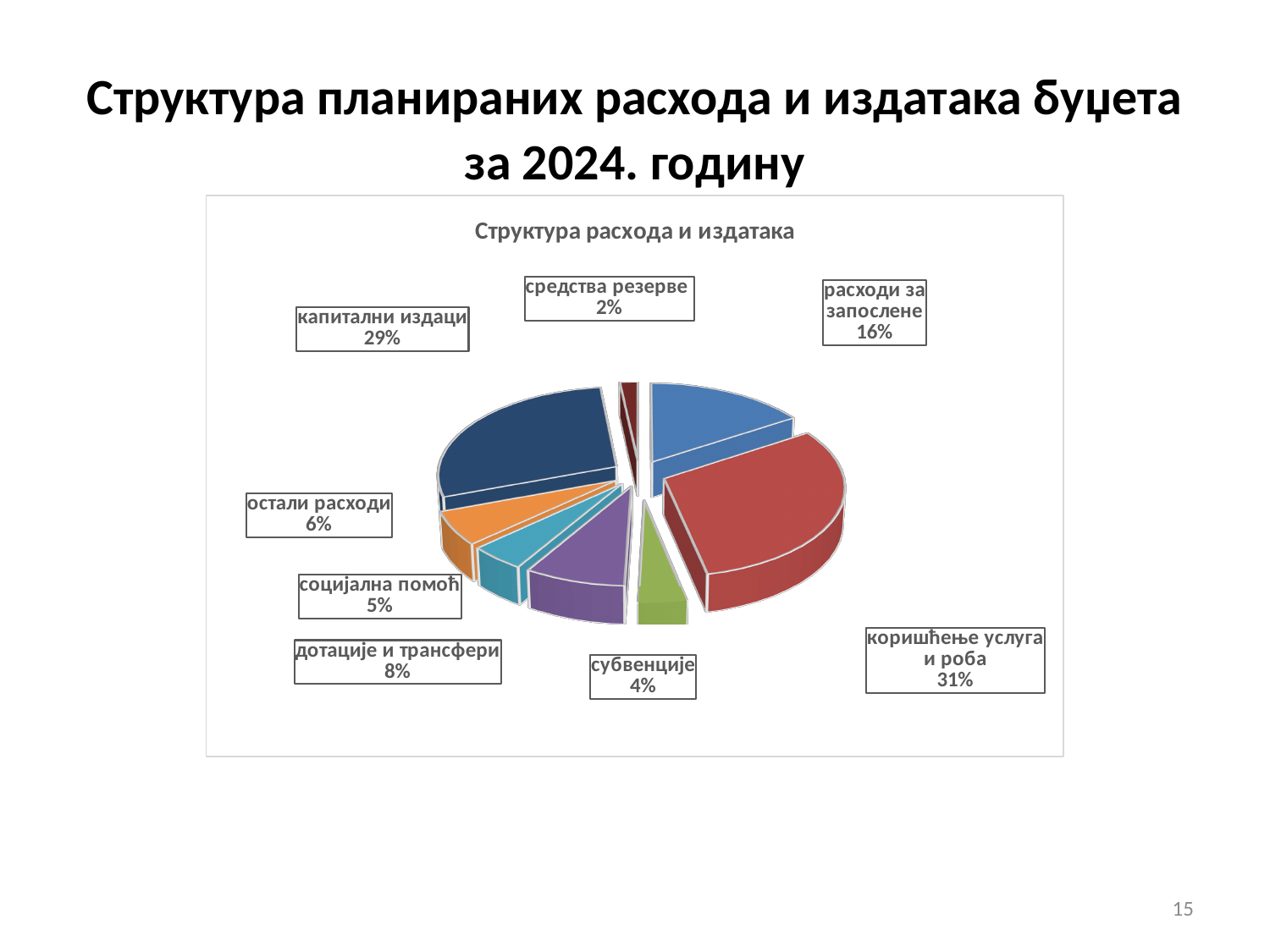
What kind of chart is shown on the slide? pie chart Which category has the largest share of the pie? коришћење услуга и роба Which is larger, the share for 'остали расходи' or the share for 'социјална помоћ'? остали расходи How many categories are shown in the pie chart? 8 What is the title of the chart? Структура расхода и издатака What is the difference between the shares of 'коришћење услуга и роба' and 'капитални издаци'? 2% Which category has the smallest share of the pie? средства резерве What is the value shown for 'субвенције'? 4% What is the value shown for 'дотације и трансфери'? 8% What is the value shown for 'капитални издаци'? 29% What is the value shown for 'расходи за запослене'? 16% What share of the pie does 'коришћење услуга и роба' represent? 31%